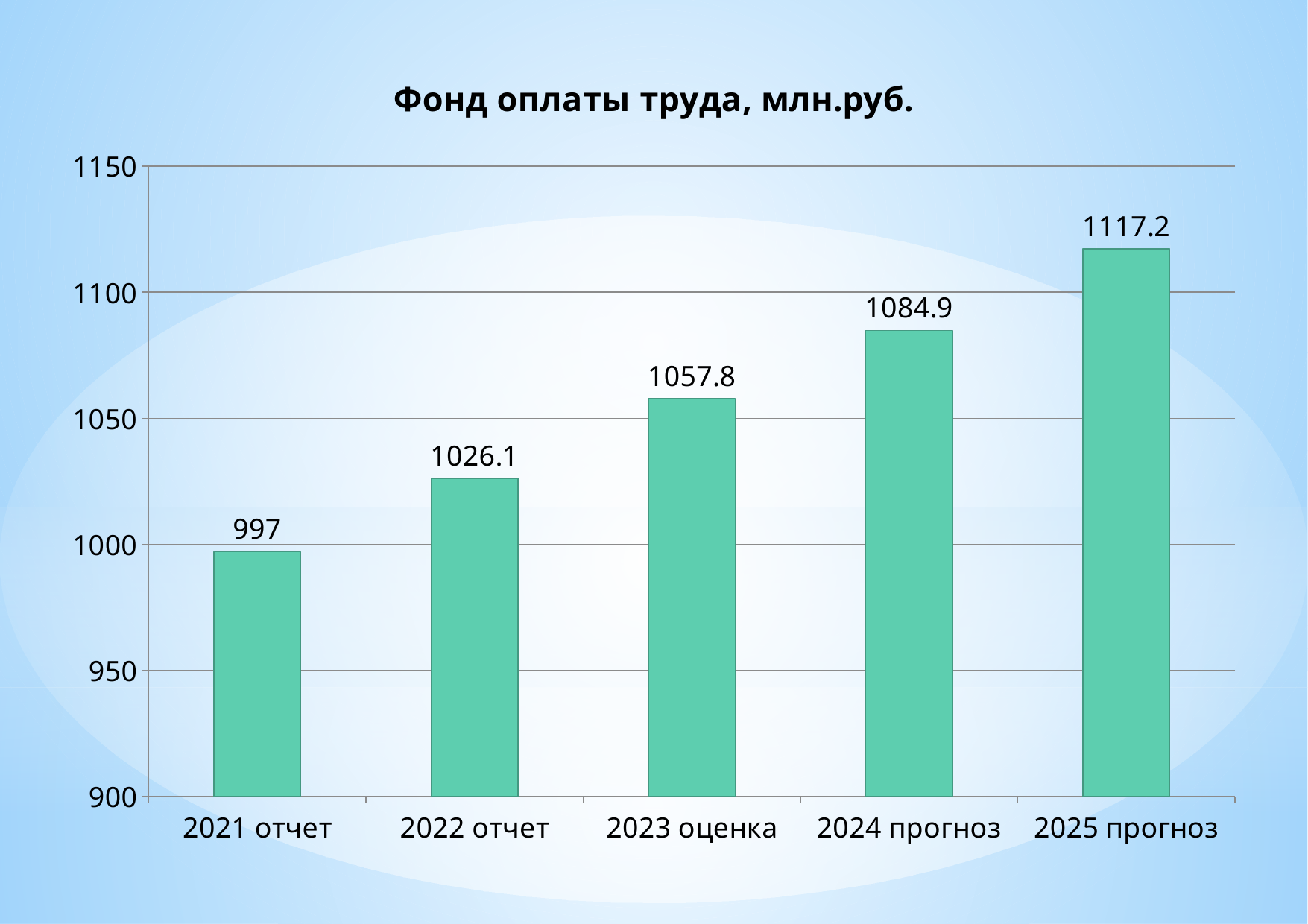
What kind of chart is shown on the slide? bar chart Is the value for 2024 прогноз greater or less than 1100? less Do the values rise or fall from 2021 отчет to 2025 прогноз? rise What is the value for 2023 оценка? 1057.8 Which category has the lowest value? 2021 отчет What is the difference between the values for 2024 прогноз and 2023 оценка? 27.1 What is the difference between the values for 2022 отчет and 2021 отчет? 29.1 Which is larger, the value for 2022 отчет or the value for 2024 прогноз? 2024 прогноз Which category has the highest value? 2025 прогноз How many categories are shown on the x axis? 5 What is the value for 2025 прогноз? 1117.2 What is the value for 2021 отчет? 997